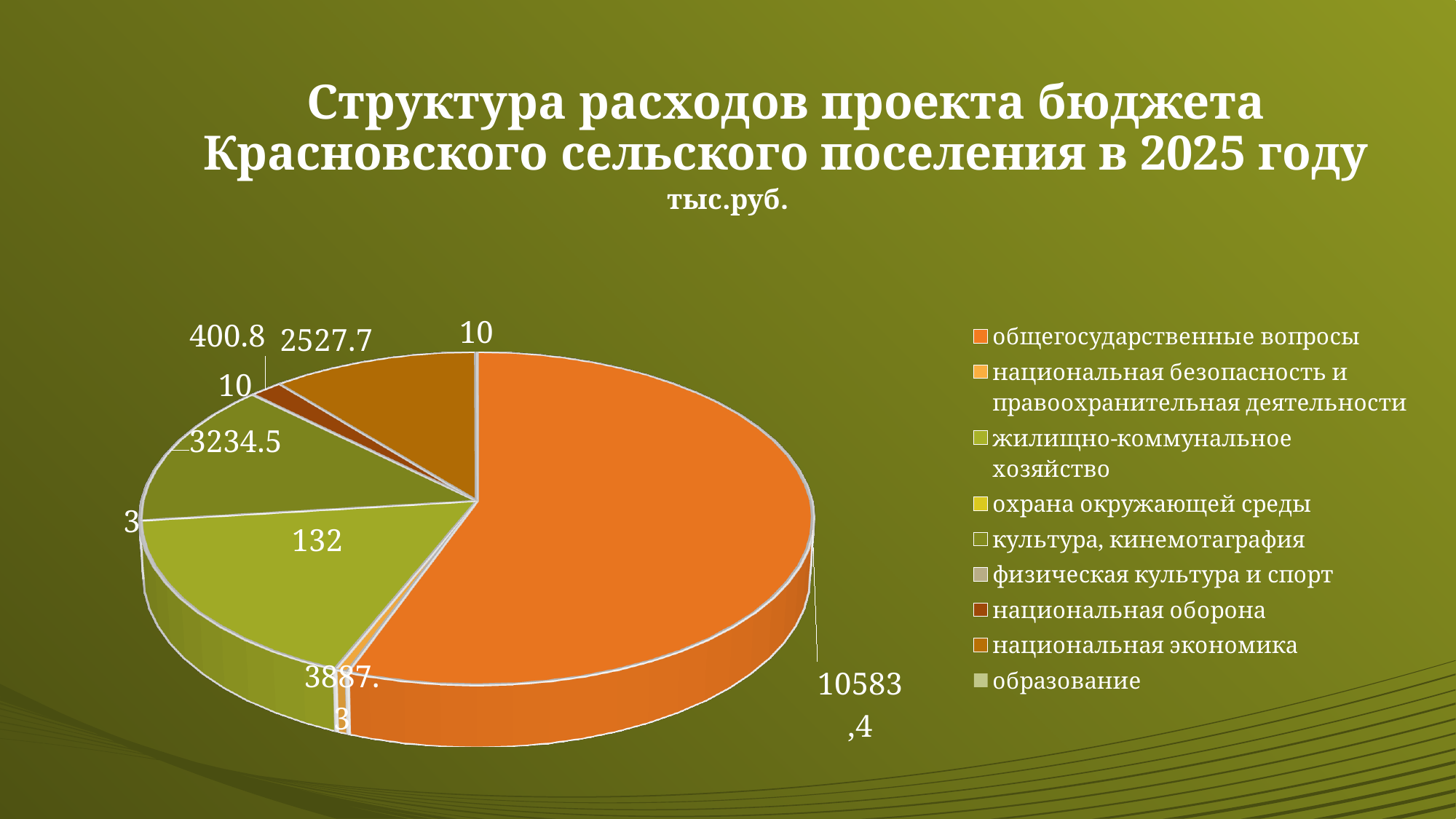
What is the title of the chart on the slide? Структура расходов проекта бюджета Красновского сельского поселения в 2025 году What is the difference between the values for общегосударственные вопросы and национальная экономика? 8055.7 What is the value for национальная экономика? 2527.7 How many entries does the legend list? 9 Which category has the largest slice of the pie? общегосударственные вопросы How many data labels are shown on the pie chart? 9 What kind of chart is shown on the slide? pie chart What is the value for национальная оборона? 400.8 What is the value for общегосударственные вопросы? 10583,4 What is the value for жилищно-коммунальное хозяйство? 3887.3 In what units are the values on the chart given? тыс.руб. Which is larger: общегосударственные вопросы or национальная экономика? общегосударственные вопросы